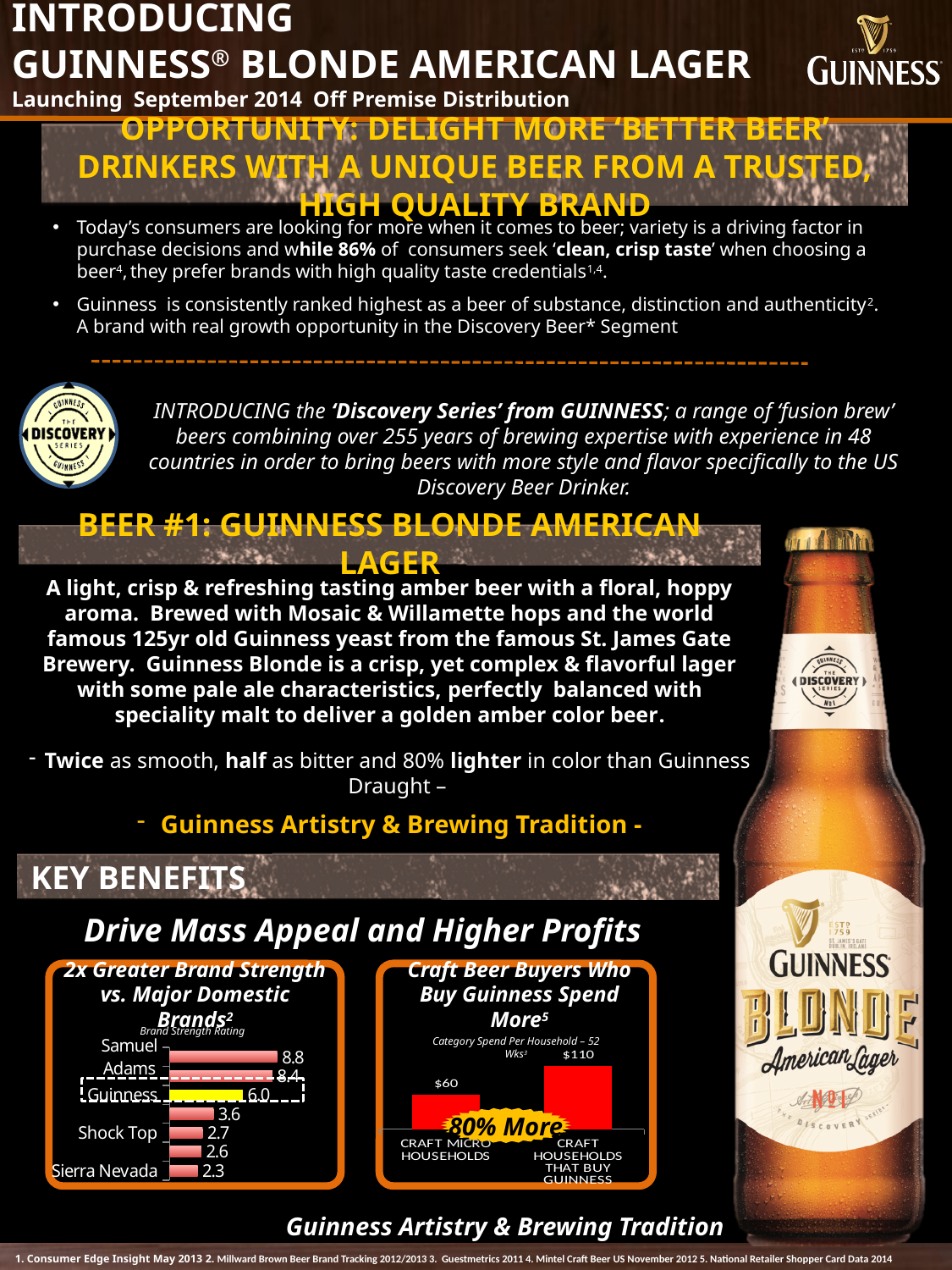
In the '2x Greater Brand Strength vs. Major Domestic Brands' chart, how many bars are plotted? 7 In the '2x Greater Brand Strength vs. Major Domestic Brands' chart, how much higher is Guinness's rating than Shock Top's? 3.3 In the 'Craft Beer Buyers Who Buy Guinness Spend More' chart, which group has the higher spend per household? Craft Households That Buy Guinness In the '2x Greater Brand Strength vs. Major Domestic Brands' chart, what is the brand strength rating for Samuel Adams? 8.8 In the '2x Greater Brand Strength vs. Major Domestic Brands' chart, which brand has the lowest brand strength rating? Sierra Nevada In the '2x Greater Brand Strength vs. Major Domestic Brands' chart, what is the brand strength rating for Sierra Nevada? 2.3 In the 'Craft Beer Buyers Who Buy Guinness Spend More' chart, what is the category spend per household for Craft Micro Households? $60 In the '2x Greater Brand Strength vs. Major Domestic Brands' chart, what is the brand strength rating for Guinness? 6.0 In the 'Craft Beer Buyers Who Buy Guinness Spend More' chart, what is the difference in spend between Craft Households That Buy Guinness and Craft Micro Households? $50 What type of chart is the 'Craft Beer Buyers Who Buy Guinness Spend More' chart? Bar chart In the 'Craft Beer Buyers Who Buy Guinness Spend More' chart, how many bars are plotted? 2 In the 'Craft Beer Buyers Who Buy Guinness Spend More' chart, what is the category spend per household for Craft Households That Buy Guinness? $110